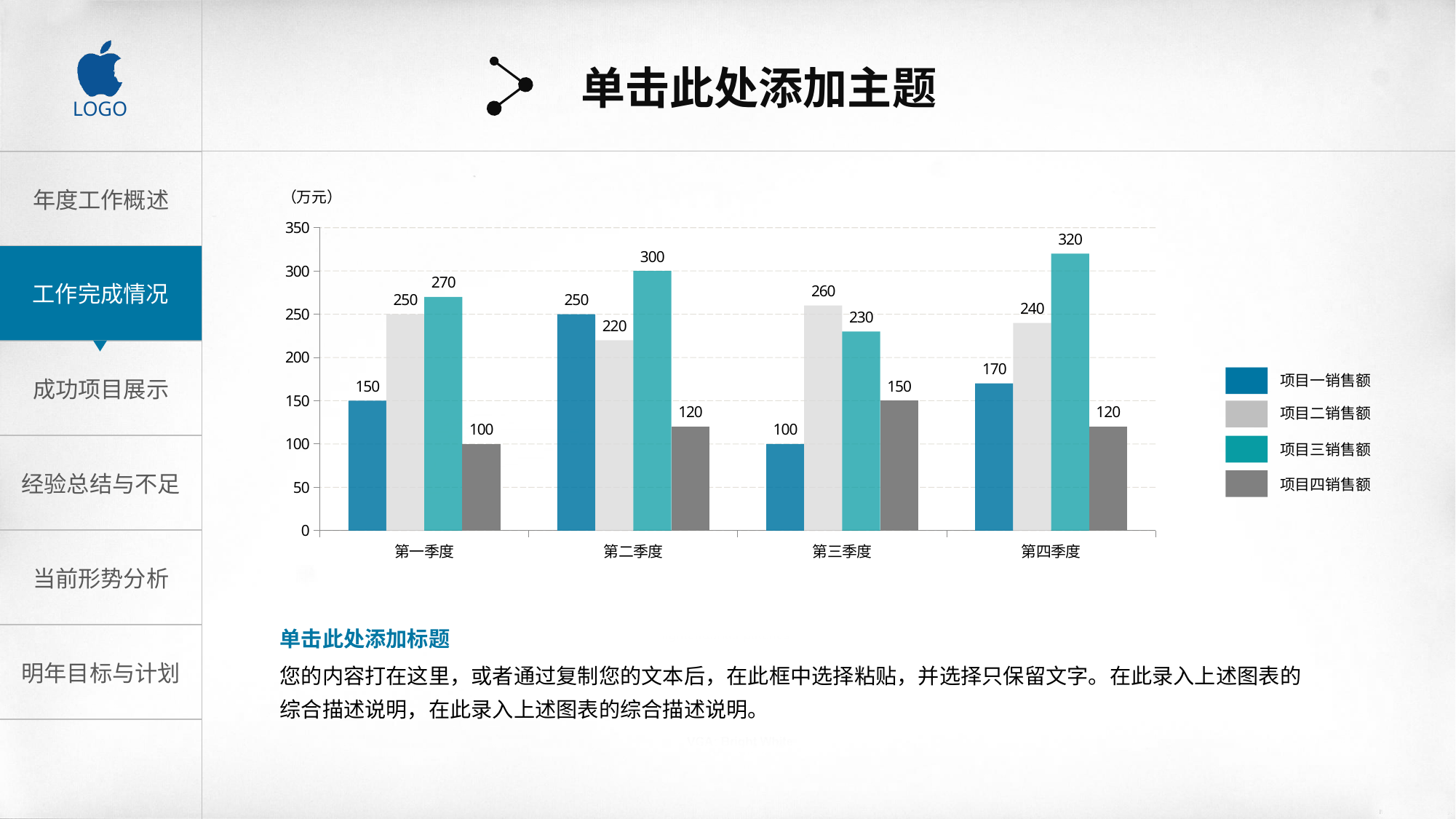
How many quarters (categories) are shown on the x axis? 4 How many series does the legend list? 4 Which quarter has the highest value for 项目三销售额? 第四季度 What unit is shown above the y axis of the chart? 万元 What is the value for 项目一销售额 in 第二季度? 250 Which quarter has the lowest value for 项目一销售额? 第三季度 Does the value for 项目四销售额 rise or fall from 第三季度 to 第四季度? Fall Which is larger in 第三季度: 项目二销售额 or 项目三销售额? 项目二销售额 What is the value for 项目三销售额 in 第四季度? 320 What is the value for 项目四销售额 in 第三季度? 150 What kind of chart is shown on the slide? Bar chart What is the difference between 项目三销售额 and 项目四销售额 in 第二季度? 180